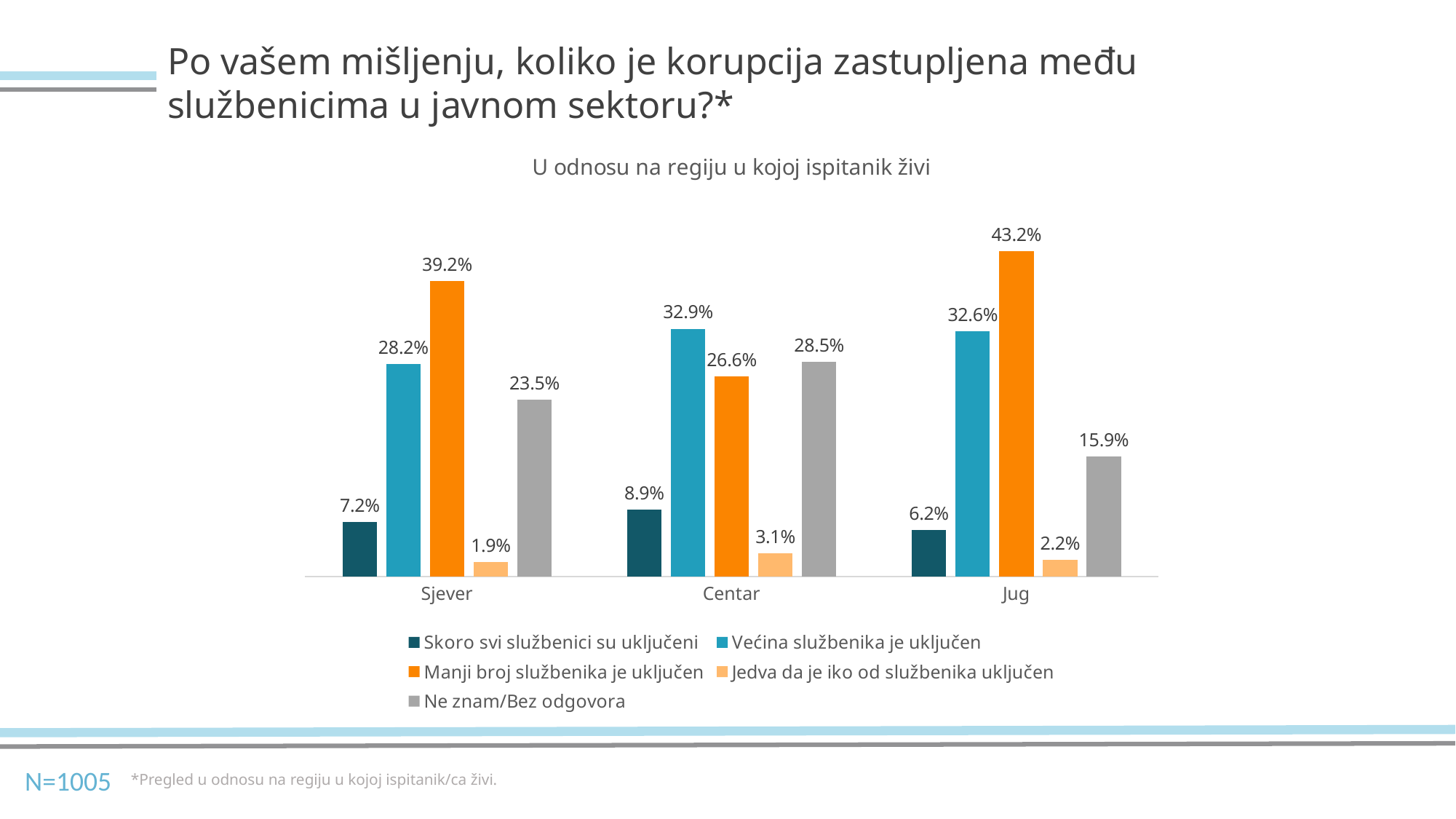
What is the value for "Većina službenika je uključen" in the Centar region? 32.9% Which is larger in the Centar region: "Većina službenika je uključen" or "Manji broj službenika je uključen"? Većina službenika je uključen What is the subtitle shown above the chart? U odnosu na regiju u kojoj ispitanik živi How many regions are shown on the x axis? 3 How many series does the legend list? 5 What is the difference between the "Manji broj službenika je uključen" values for Jug and Sjever? 4.0% What kind of chart is shown on the slide? Bar chart Which region has the lowest value for "Skoro svi službenici su uključeni"? Jug What is the value for "Manji broj službenika je uključen" in the Jug region? 43.2% What is the value for "Ne znam/Bez odgovora" in the Sjever region? 23.5% Which region has the highest value for "Manji broj službenika je uključen"? Jug What is the value for "Jedva da je iko od službenika uključen" in the Centar region? 3.1%